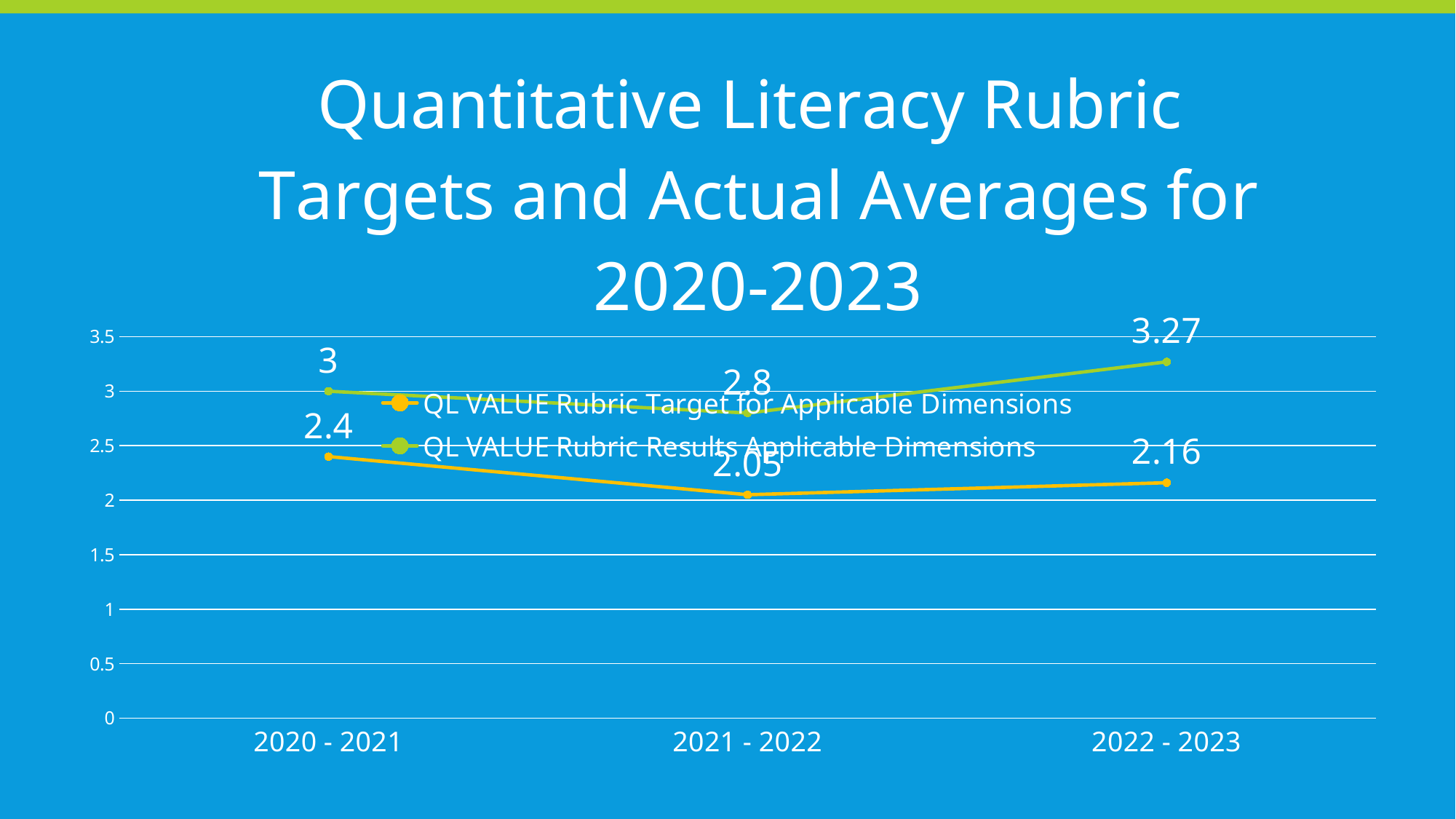
Which series is drawn in green? QL VALUE Rubric Results Applicable Dimensions What is the difference between the Results value and the Target value for 2022 - 2023? 1.11 What is the QL VALUE Rubric Target for Applicable Dimensions value for 2021 - 2022? 2.05 What is the QL VALUE Rubric Results Applicable Dimensions value for 2022 - 2023? 3.27 In which year is the QL VALUE Rubric Target for Applicable Dimensions value highest? 2020 - 2021 How many series does the legend list? 2 Which is larger for 2021 - 2022: the Target value or the Results value? Results (2.8) What type of chart is shown on the slide? Line chart Is the QL VALUE Rubric Results Applicable Dimensions value for 2022 - 2023 greater or less than 3? greater How many academic years are plotted on the x axis? 3 In which year is the QL VALUE Rubric Results Applicable Dimensions value lowest? 2021 - 2022 What is the QL VALUE Rubric Target for Applicable Dimensions value for 2020 - 2021? 2.4